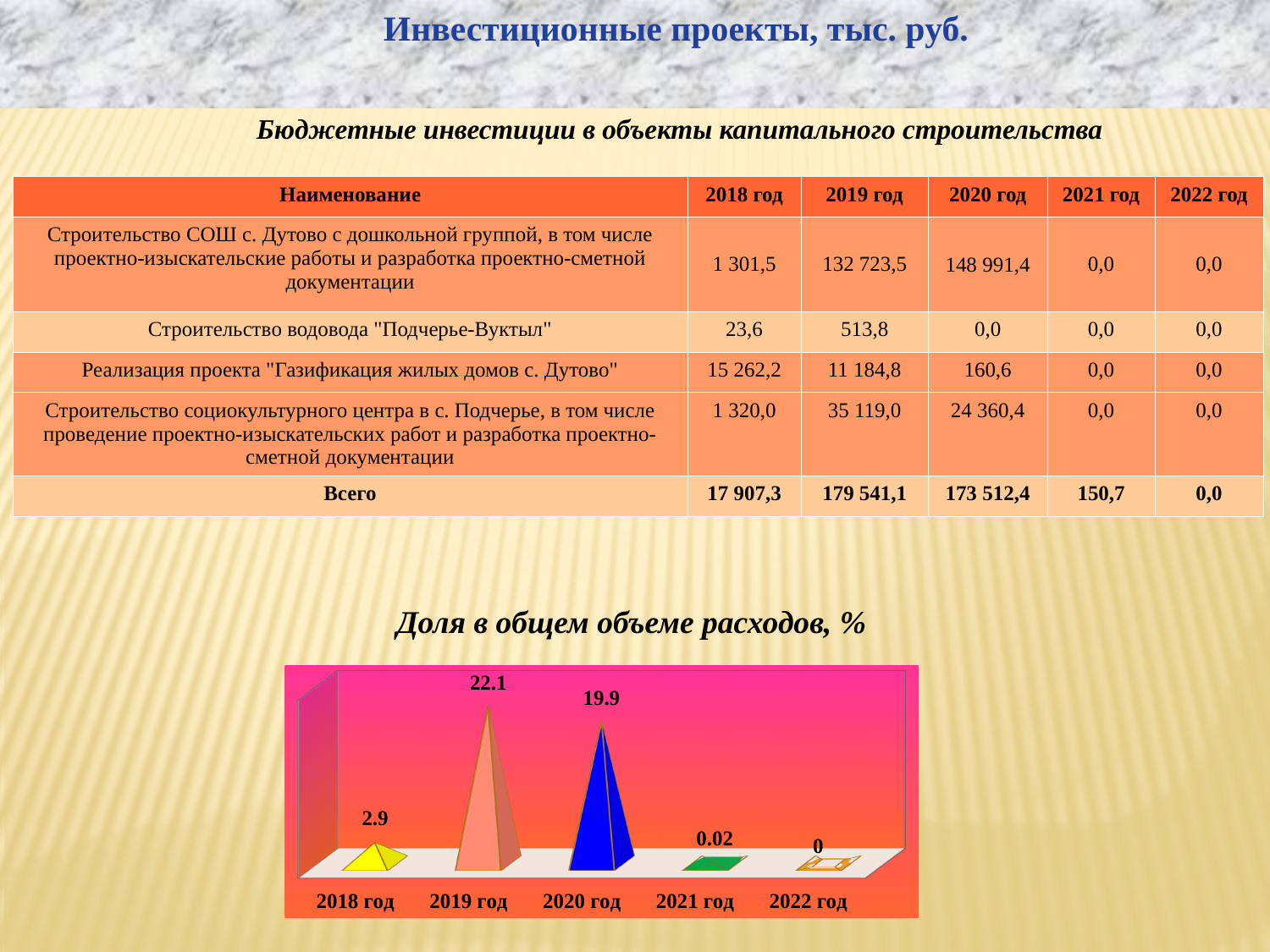
What is the title of the chart at the bottom of the slide? Доля в общем объеме расходов, % Which year has the lowest value in the chart "Доля в общем объеме расходов, %"? 2022 год What is the value for 2018 год in the chart "Доля в общем объеме расходов, %"? 2.9 What is the value for 2021 год in the chart "Доля в общем объеме расходов, %"? 0.02 What is the value for 2019 год in the chart "Доля в общем объеме расходов, %"? 22.1 What is the value for 2022 год in the chart "Доля в общем объеме расходов, %"? 0 In the chart "Доля в общем объеме расходов, %", which is larger: the value for 2018 год or the value for 2020 год? 2020 год In the chart "Доля в общем объеме расходов, %", what is the difference between the values for 2019 год and 2020 год? 2.2 Which year has the highest value in the chart "Доля в общем объеме расходов, %"? 2019 год What kind of chart is "Доля в общем объеме расходов, %"? bar chart How many years are shown on the x axis of the chart "Доля в общем объеме расходов, %"? 5 What is the value for 2020 год in the chart "Доля в общем объеме расходов, %"? 19.9